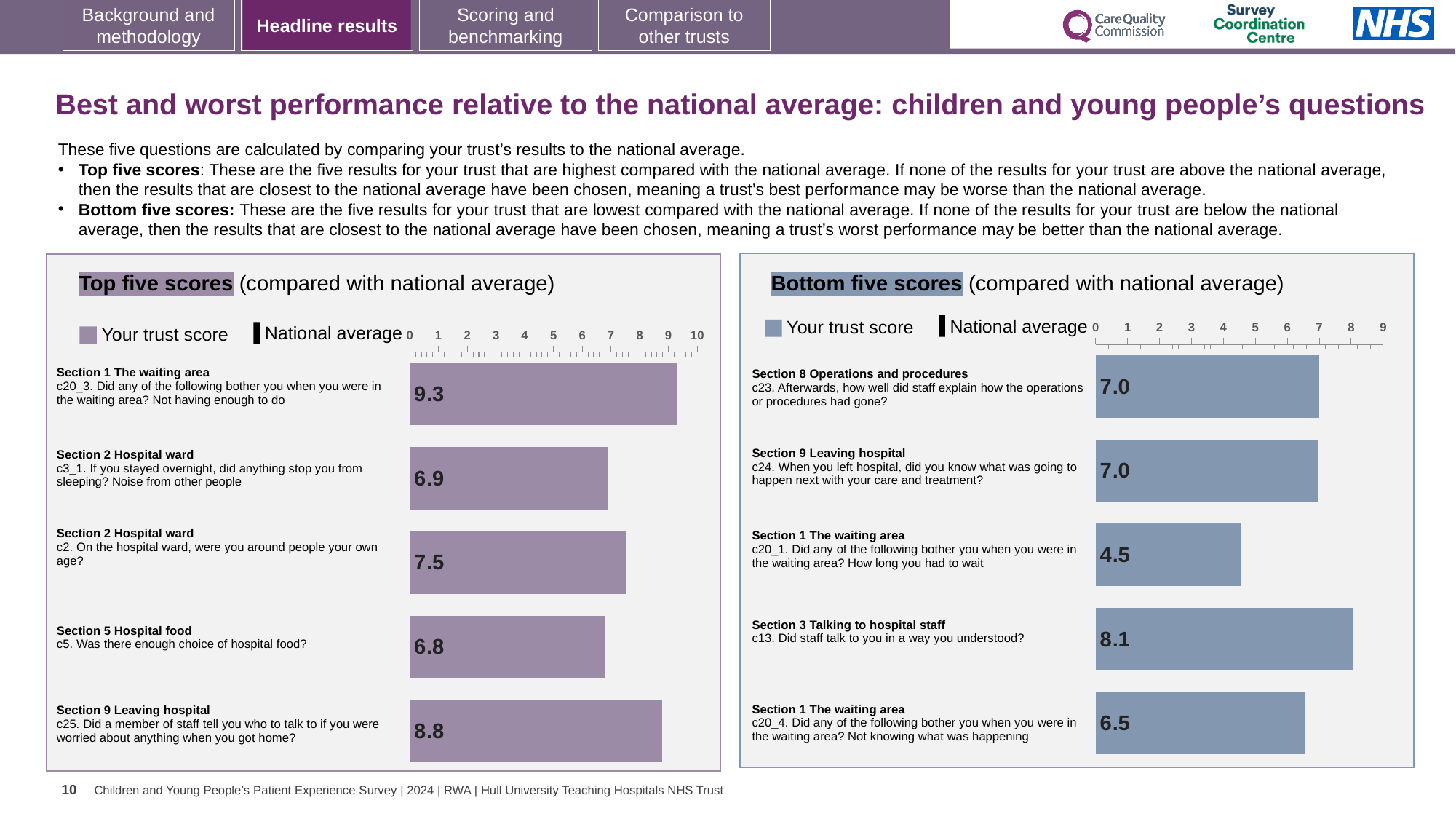
In the 'Top five scores' chart, which question has the highest trust score? c20_3 (Not having enough to do in the waiting area) How many entries does the legend of the 'Top five scores' chart list? 2 In the 'Bottom five scores' chart, what is the trust score for c13 (Did staff talk to you in a way you understood?)? 8.1 In the 'Bottom five scores' chart, what is the difference between the scores for c13 and c20_1? 3.6 What type of chart is the 'Bottom five scores' chart? Bar chart In the 'Bottom five scores' chart, which question has the lowest trust score? c20_1 (How long you had to wait) In the 'Top five scores' chart, what is the trust score for c5 (Was there enough choice of hospital food?)? 6.8 In the 'Bottom five scores' chart, what is the trust score for c20_1 (How long you had to wait)? 4.5 How many questions are plotted in the 'Top five scores' chart? 5 In the 'Bottom five scores' chart, which is larger: the score for c23 or the score for c20_4? c23 In the 'Top five scores' chart, what is the trust score for c20_3 (Not having enough to do in the waiting area)? 9.3 In the 'Top five scores' chart, what is the difference between the scores for c20_3 and c25? 0.5